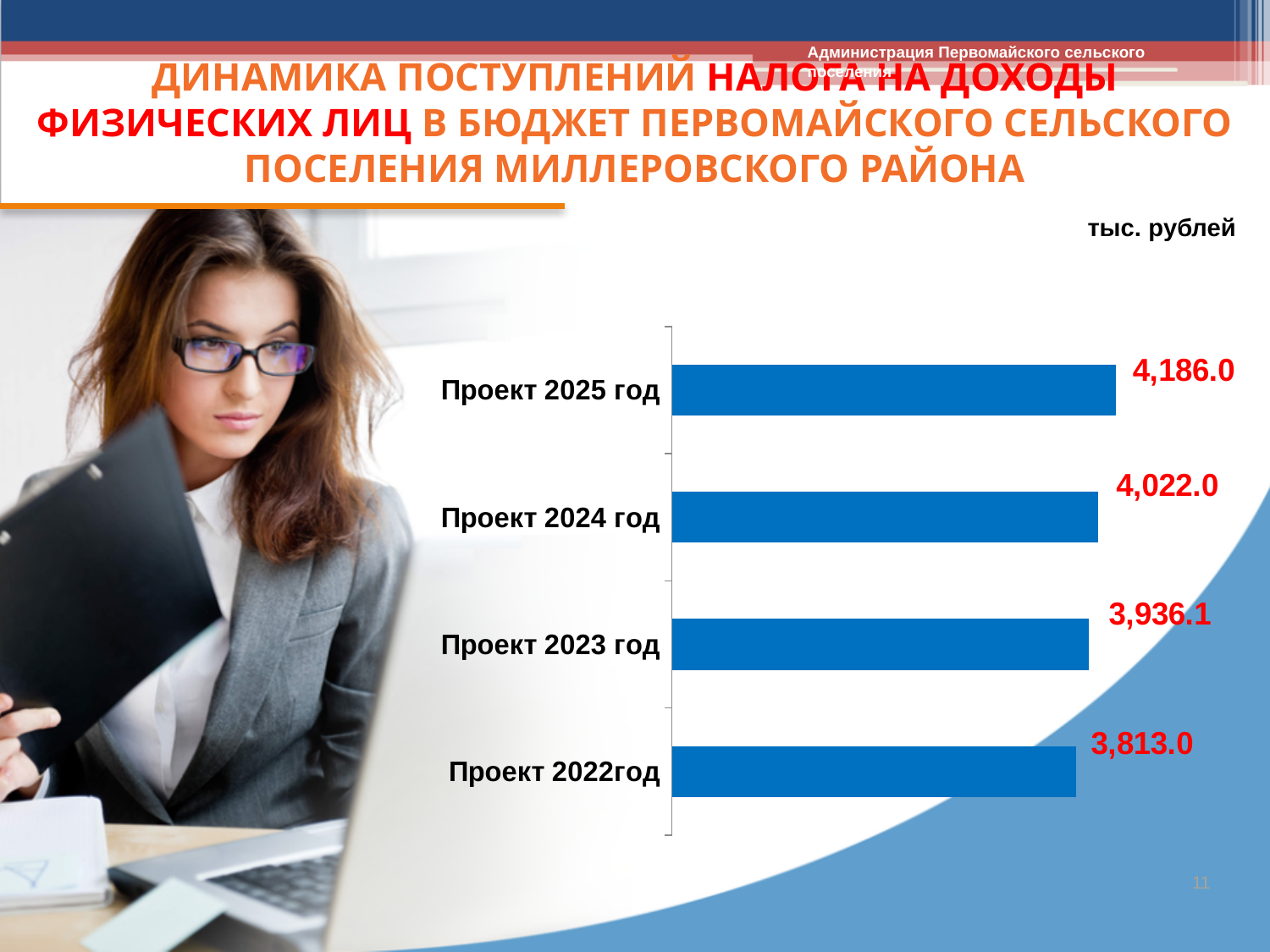
Which category has the highest value? Проект 2025 год Which is larger, the value for Проект 2023 год or the value for Проект 2022год? Проект 2023 год What is the value for Проект 2022год? 3,813.0 What is the value for Проект 2024 год? 4,022.0 What is the value for Проект 2023 год? 3,936.1 What is the difference between the values for Проект 2025 год and Проект 2024 год? 164.0 What is the value for Проект 2025 год? 4,186.0 In what units are the chart values given? тыс. рублей What is the difference between the values for Проект 2025 год and Проект 2022год? 373.0 Which category has the lowest value? Проект 2022год How many categories are shown in the chart? 4 What kind of chart is shown on the slide? Bar chart